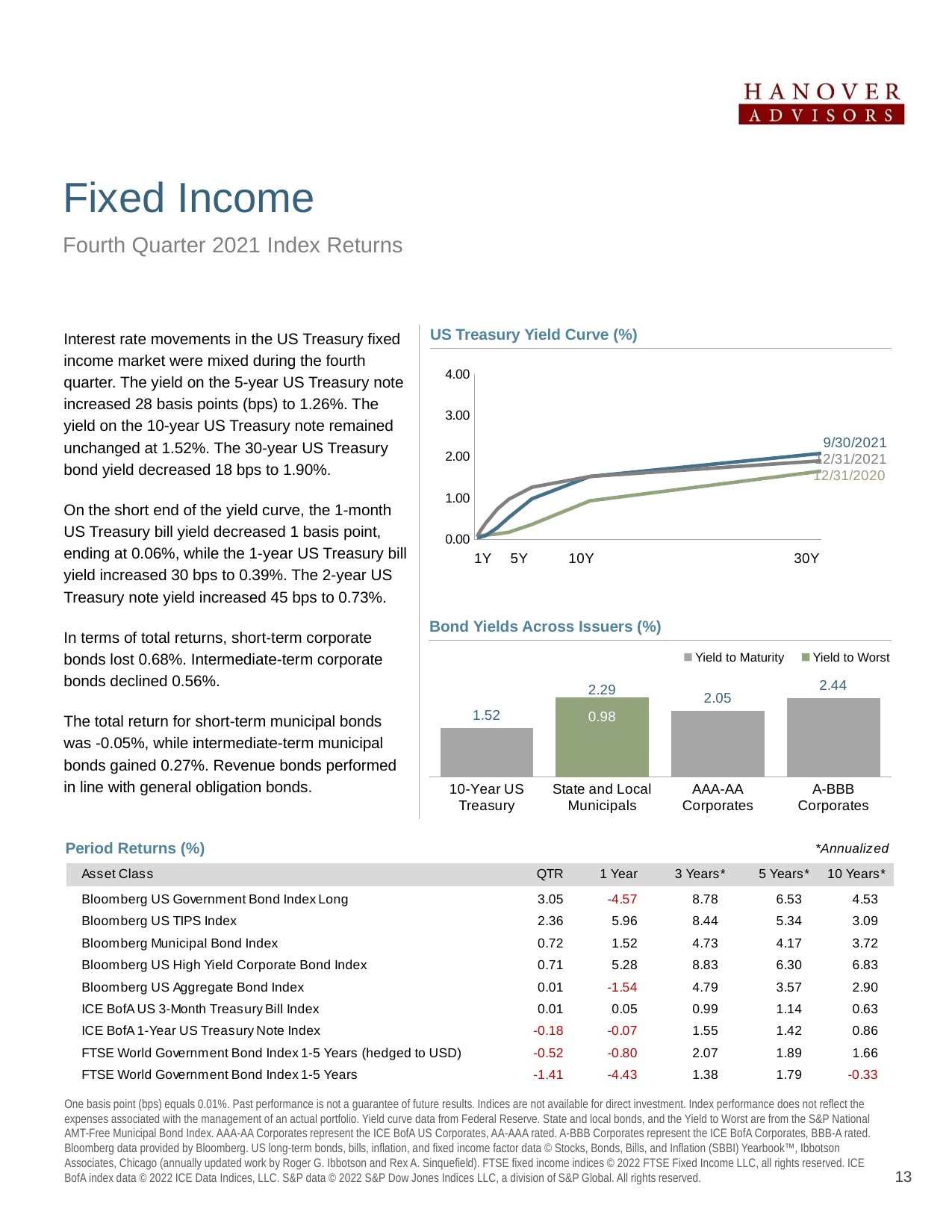
In the Bond Yields Across Issuers chart, what is the Yield to Maturity for AAA-AA Corporates? 2.05 How many series does the legend of the Bond Yields Across Issuers chart list? 2 In the US Treasury Yield Curve chart, is the 12/31/2020 value at 30Y greater or less than 2.00? less In the Bond Yields Across Issuers chart, what is the difference between the Yield to Maturity of A-BBB Corporates and AAA-AA Corporates? 0.39 In the Bond Yields Across Issuers chart, which issuer category has the lowest Yield to Maturity? 10-Year US Treasury In the Bond Yields Across Issuers chart, which issuer category has the highest Yield to Maturity? A-BBB Corporates In the US Treasury Yield Curve chart, do the yields rise or fall as maturity increases from 1Y to 30Y? Rise In the Bond Yields Across Issuers chart, which is larger: the Yield to Maturity for State and Local Municipals or for AAA-AA Corporates? State and Local Municipals How many issuer categories are shown in the Bond Yields Across Issuers chart? 4 What kind of chart is the US Treasury Yield Curve chart? Line chart In the Bond Yields Across Issuers chart, what is the Yield to Worst for State and Local Municipals? 0.98 In the Bond Yields Across Issuers chart, what is the Yield to Maturity for the 10-Year US Treasury? 1.52